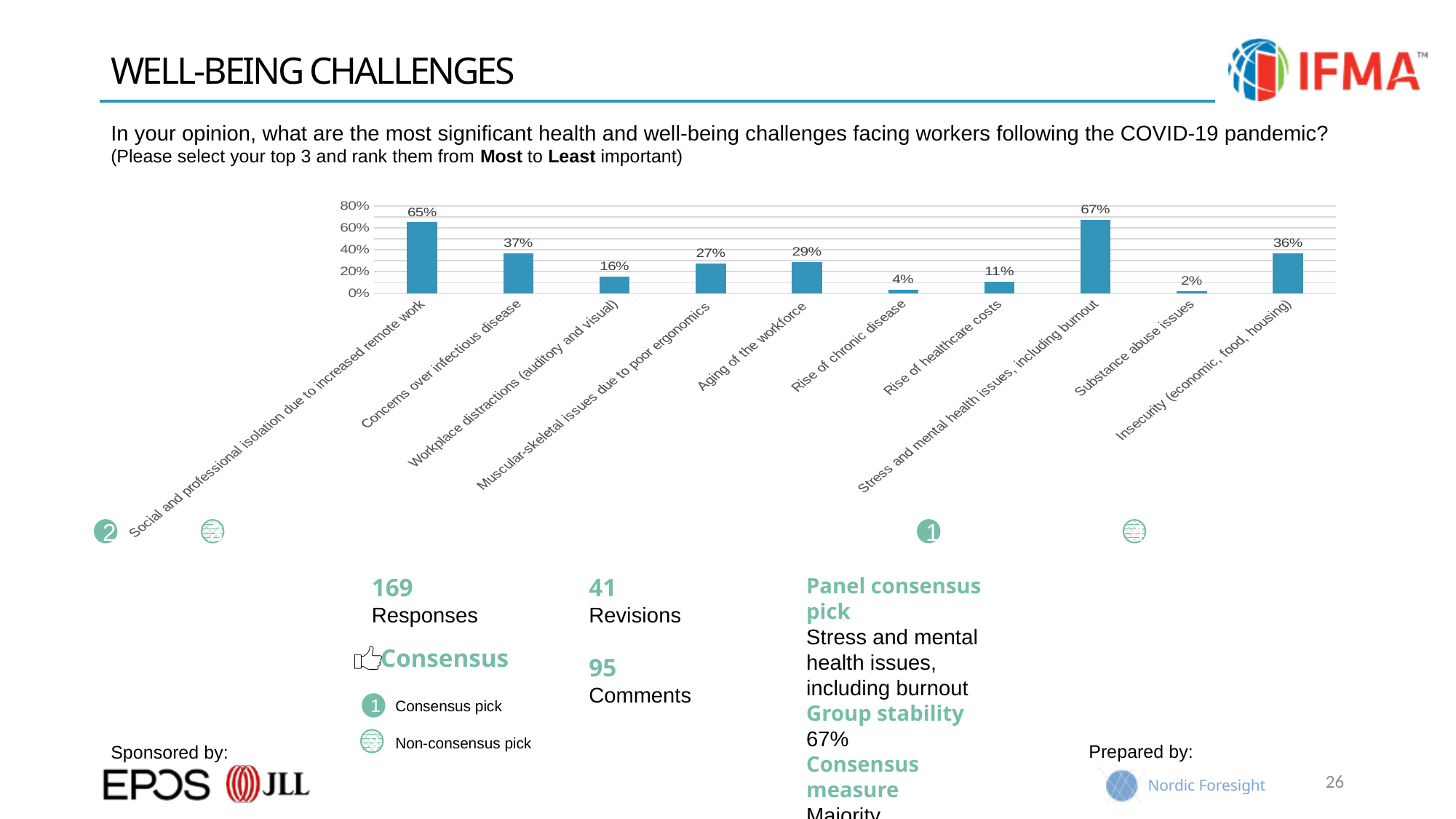
What is the difference between the values for Concerns over infectious disease and Workplace distractions (auditory and visual)? 21% What is the value for Insecurity (economic, food, housing)? 36% What kind of chart is shown on the slide? bar chart Which is larger: the value for Aging of the workforce or the value for Muscular-skeletal issues due to poor ergonomics? Aging of the workforce What is the highest value shown on the vertical axis? 80% Which category has the lowest value? Substance abuse issues What is the value for Rise of healthcare costs? 11% How many categories are shown on the chart? 10 What is the value for Social and professional isolation due to increased remote work? 65% Which category has the highest value? Stress and mental health issues, including burnout What is the value for Stress and mental health issues, including burnout? 67% Is the value for Rise of chronic disease greater or less than 20%? less